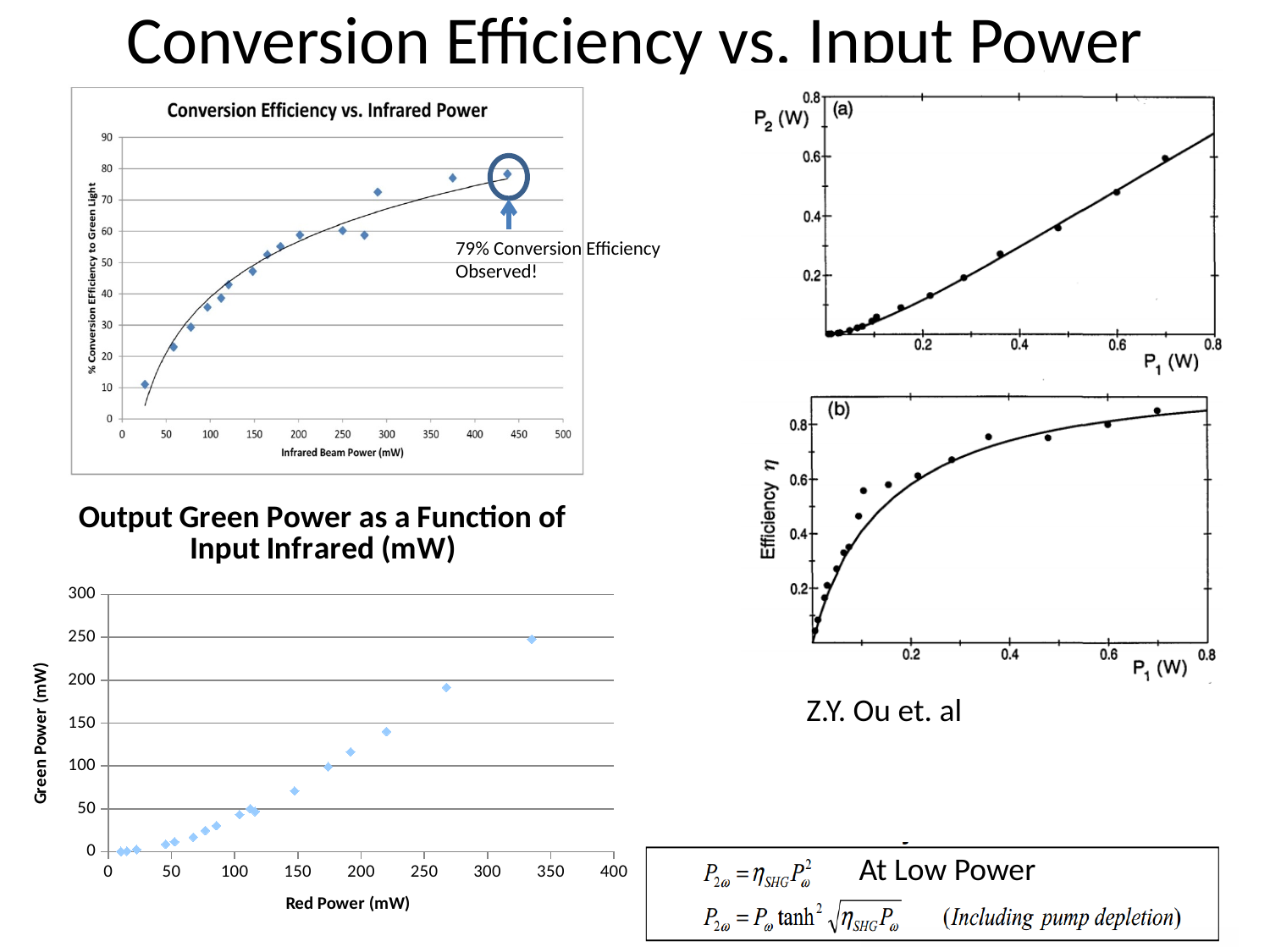
In the top-right chart (a) from Z.Y. Ou et al., is P2 at P1 = 0.7 W greater or less than 0.4? greater What is the x-axis title of the top-left chart 'Conversion Efficiency vs. Infrared Power'? Infrared Beam Power (mW) In the top-left chart 'Conversion Efficiency vs. Infrared Power', does conversion efficiency rise or fall as infrared beam power increases? rise In the bottom-left chart 'Output Green Power as a Function of Input Infrared (mW)', does green power rise or fall as red power increases? rise In the bottom-right chart (b) from Z.Y. Ou et al., is the efficiency at P1 = 0.2 W greater or less than 0.8? less In the bottom-left chart 'Output Green Power as a Function of Input Infrared (mW)', is the green power at the highest red power (about 335 mW) greater or less than 200? greater What kind of chart is the top-left chart titled 'Conversion Efficiency vs. Infrared Power'? scatter chart In the top-left chart 'Conversion Efficiency vs. Infrared Power', what conversion efficiency is annotated for the circled highest point? 79% What is the y-axis title of the bottom-left chart 'Output Green Power as a Function of Input Infrared (mW)'? Green Power (mW)